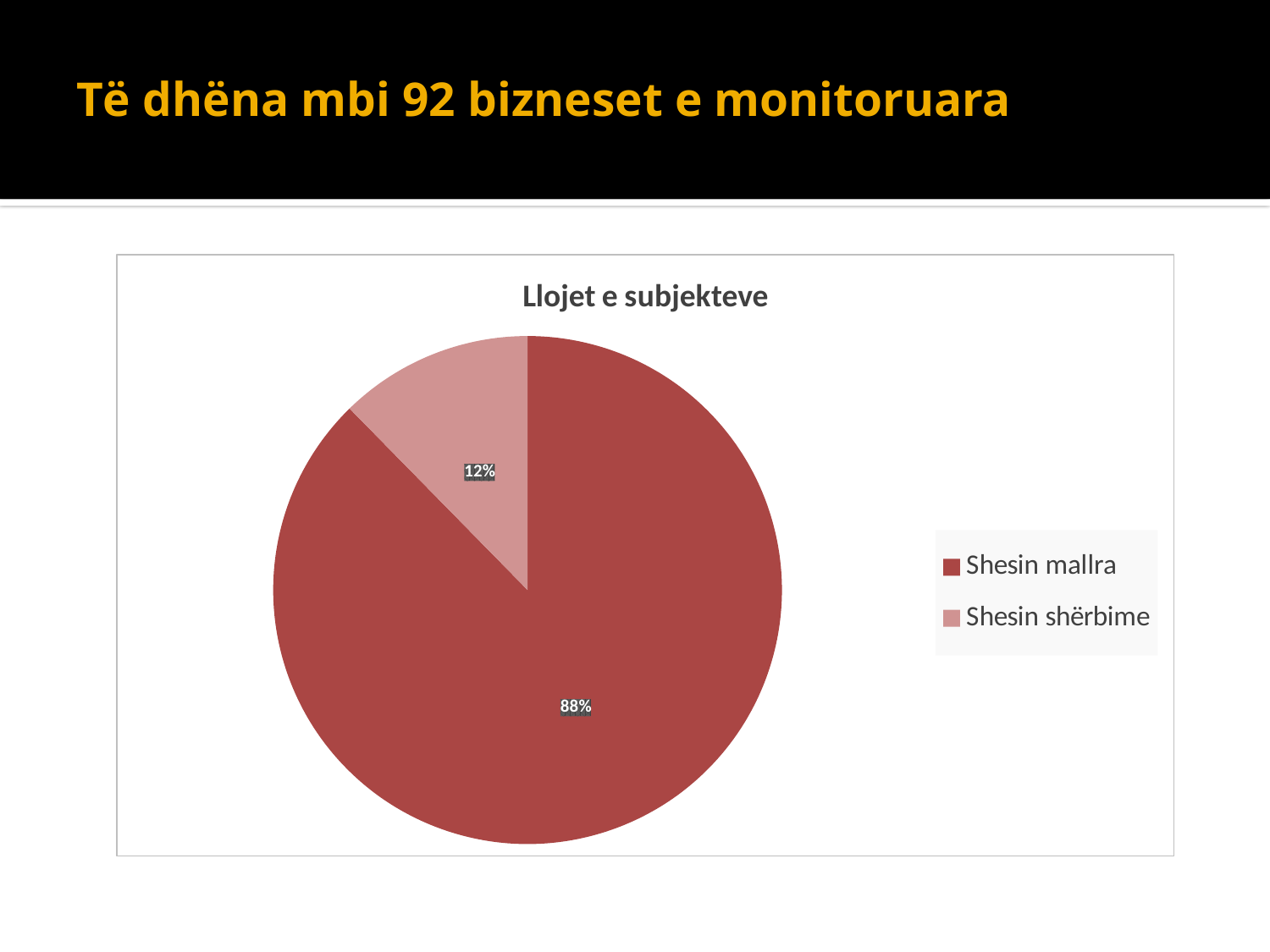
What share of the pie does "Shesin mallra" represent? 88% What share of the pie does "Shesin shërbime" represent? 12% Which category has the smallest slice of the pie? Shesin shërbime What is the difference in percentage points between "Shesin mallra" and "Shesin shërbime"? 76% How many entries does the legend list? 2 Which legend entry is shown in the lighter pink colour? Shesin shërbime What kind of chart is shown on the slide? pie chart How many slices does the pie chart have? 2 What is the title of the chart? Llojet e subjekteve Which is larger, the slice for "Shesin mallra" or the slice for "Shesin shërbime"? Shesin mallra Which category has the largest slice of the pie? Shesin mallra